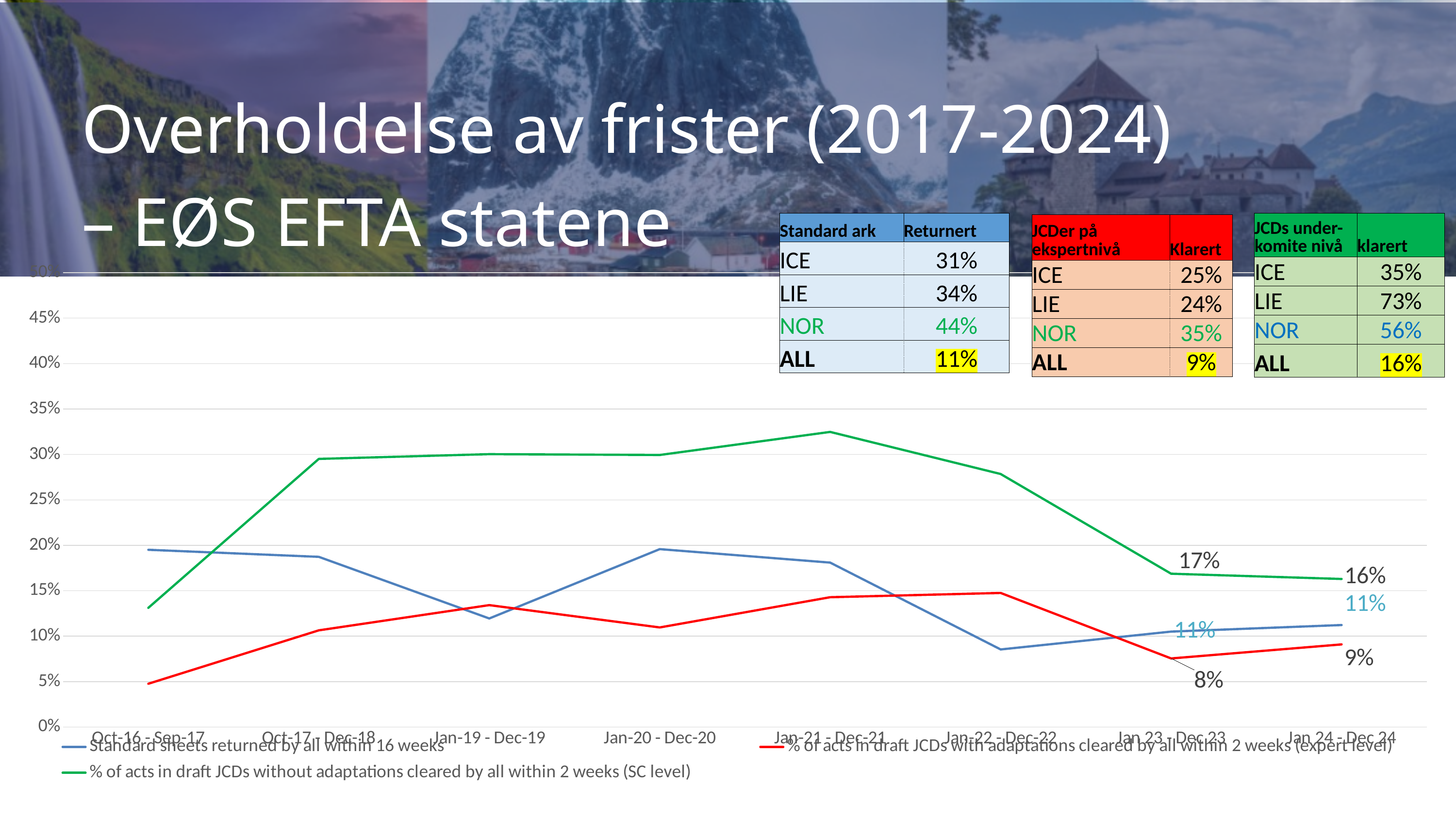
What is the value of the red series (expert level) for Jan-24 - Dec-24? 9% What is the value of the green series (SC level) for Jan-24 - Dec-24? 16% What type of chart is shown on the slide? line chart What is the value of the blue series (Standard sheets returned by all within 16 weeks) for Jan-24 - Dec-24? 11% What is the value of the red series (% of acts in draft JCDs with adaptations cleared by all within 2 weeks, expert level) for Jan-23 - Dec-23? 8% What is the value of the green series (% of acts in draft JCDs without adaptations cleared by all within 2 weeks, SC level) for Jan-23 - Dec-23? 17% How many series does the chart legend list? 3 How many time periods are shown on the x axis of the chart? 8 What is the difference between the green series and the red series for Jan-24 - Dec-24? 7% Is the value of the green series for Jan-21 - Dec-21 greater or less than 30%? greater Which series has the highest value for Jan-23 - Dec-23? % of acts in draft JCDs without adaptations cleared by all within 2 weeks (SC level) Does the green series rise or fall between Jan-21 - Dec-21 and Jan-23 - Dec-23? fall